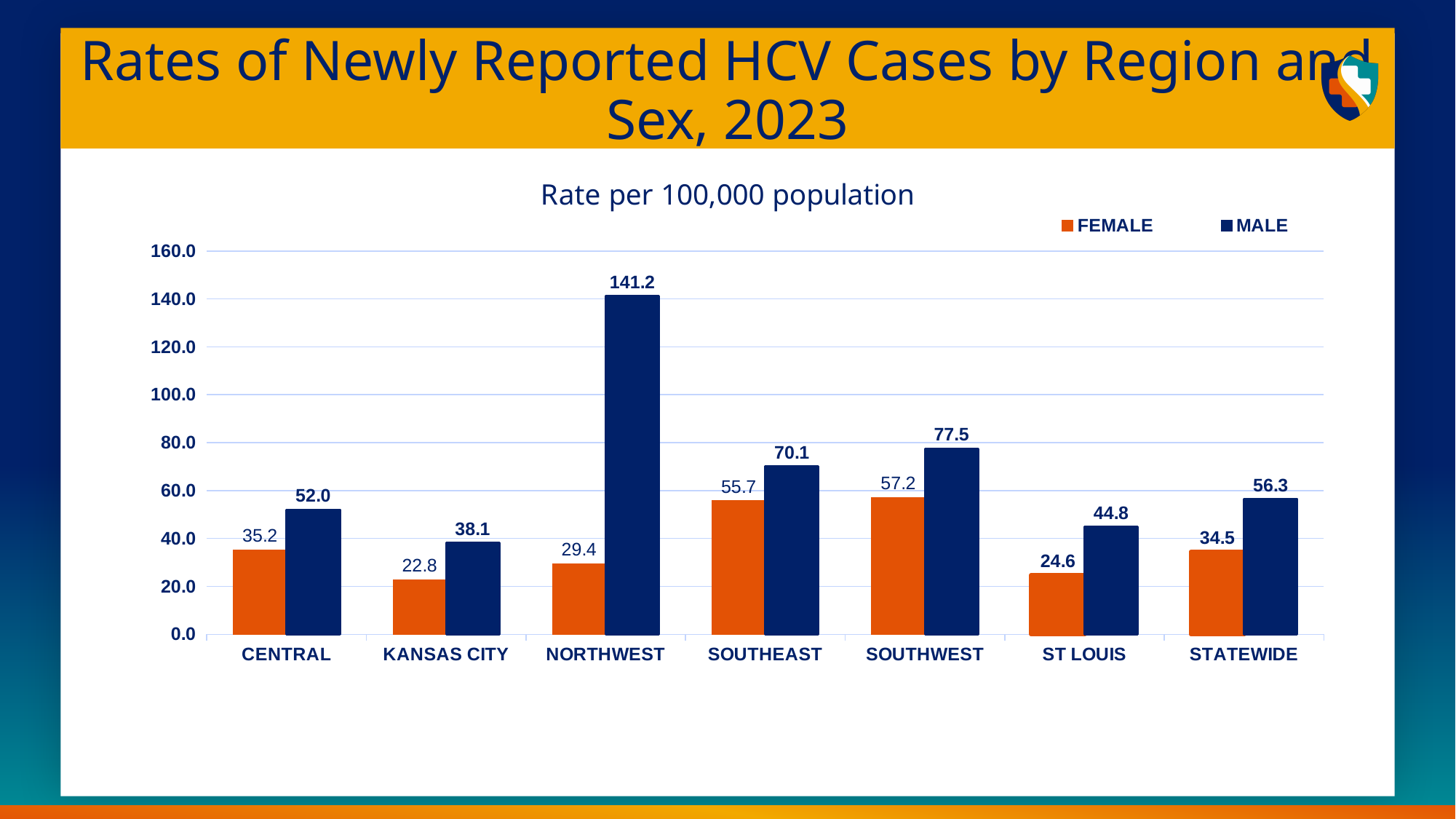
What is the FEMALE rate for STATEWIDE? 34.5 What is the difference between the MALE and FEMALE rates for SOUTHEAST? 14.4 What kind of chart is shown on the slide? bar chart Which region has the lowest FEMALE rate? KANSAS CITY What is the MALE rate for NORTHWEST? 141.2 How many regions are shown on the x axis? 7 What is the FEMALE rate for KANSAS CITY? 22.8 What is the MALE rate for ST LOUIS? 44.8 How many series does the legend list? 2 Is the MALE rate for NORTHWEST greater or less than 120.0? greater Which is larger, the FEMALE rate for SOUTHWEST or the FEMALE rate for CENTRAL? SOUTHWEST Which region has the highest MALE rate? NORTHWEST